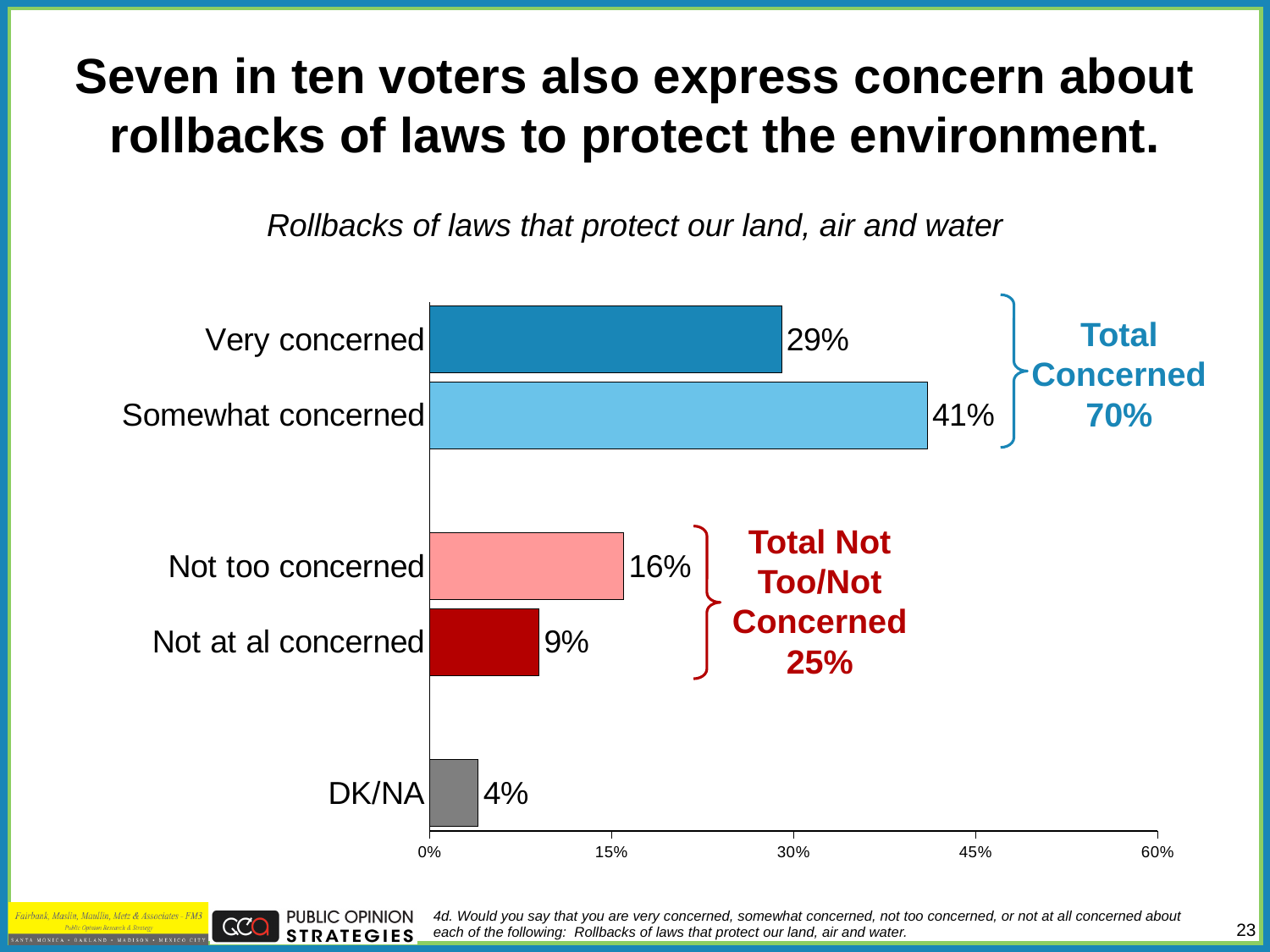
Which response category has the highest percentage? Somewhat concerned What percentage of voters are very concerned about rollbacks of laws that protect our land, air and water? 29% What percentage of voters are not too concerned? 16% What percentage of voters answered DK/NA? 4% Which response category has the lowest percentage? DK/NA What is the Total Concerned percentage shown next to the bracket on the chart? 70% What kind of chart is shown on the slide? Bar chart Which is larger, the percentage not too concerned or the percentage not at all concerned? Not too concerned What percentage of voters are somewhat concerned? 41% Is the value for somewhat concerned greater or less than 30%? greater What is the difference between the percentage somewhat concerned and the percentage very concerned? 12% How many response categories are shown in the chart? 5